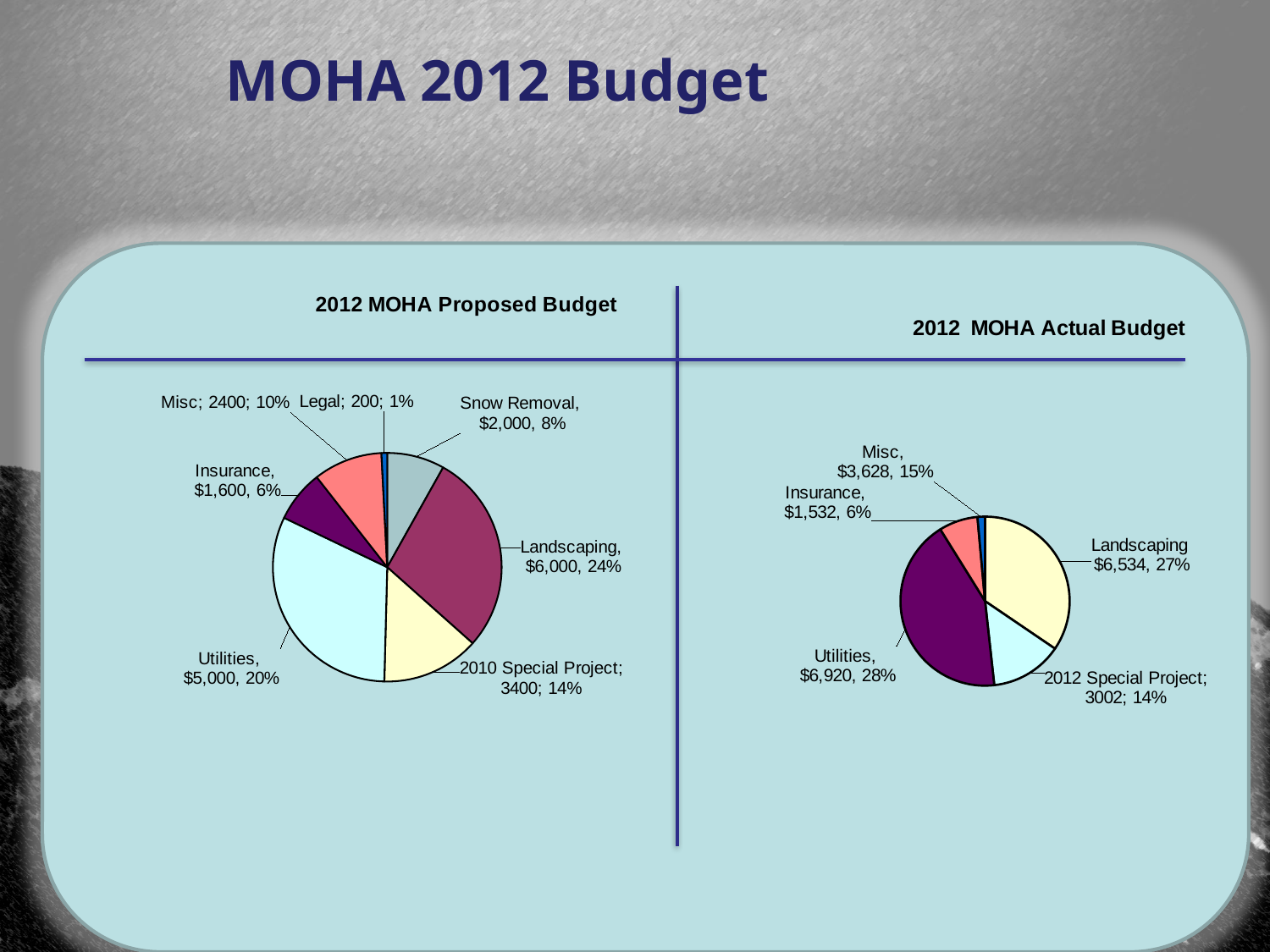
In the 2012 MOHA Proposed Budget chart, what share of the pie is Utilities? 20% In the 2012 MOHA Actual Budget chart, what share of the pie is Misc? 15% In the 2012 MOHA Actual Budget chart, how many slices does the pie have? 5 In the 2012 MOHA Proposed Budget chart, what is the difference between the Landscaping and Utilities values? $1,000 In the 2012 MOHA Actual Budget chart, which is larger, Landscaping or Misc? Landscaping In the 2012 MOHA Proposed Budget chart, what is the value for Landscaping? $6,000 In the 2012 MOHA Actual Budget chart, what is the value for Utilities? $6,920 In the 2012 MOHA Proposed Budget chart, which category has the smallest slice? Legal In the 2012 MOHA Proposed Budget chart, how many slices does the pie have? 7 What kind of chart is used on the left side of the slide? Pie chart